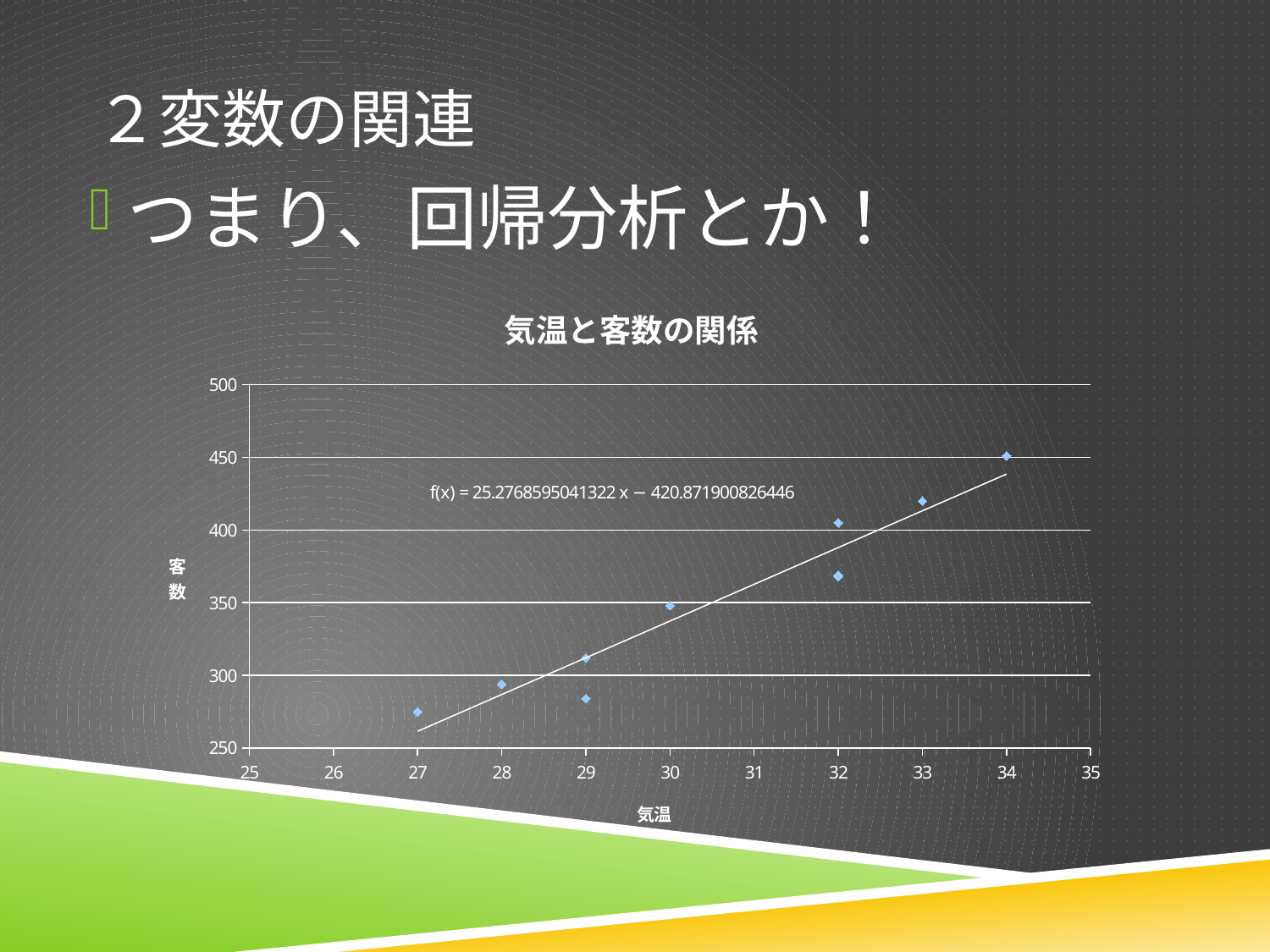
Is the 客数 value at 気温 27 greater or less than 300? less Is the 客数 value at 気温 34 greater or less than 400? greater What kind of chart is shown on the slide? scatter chart At which 気温 value is the highest 客数 plotted? 34 Which is larger, the 客数 value at 気温 34 or the 客数 value at 気温 30? 気温 34 What is the label of the x axis? 気温 Is the 客数 value at 気温 30 greater or less than 300? greater What is the title of the chart? 気温と客数の関係 Do the values of 客数 generally rise or fall as 気温 increases? rise What is the maximum value shown on the y axis? 500